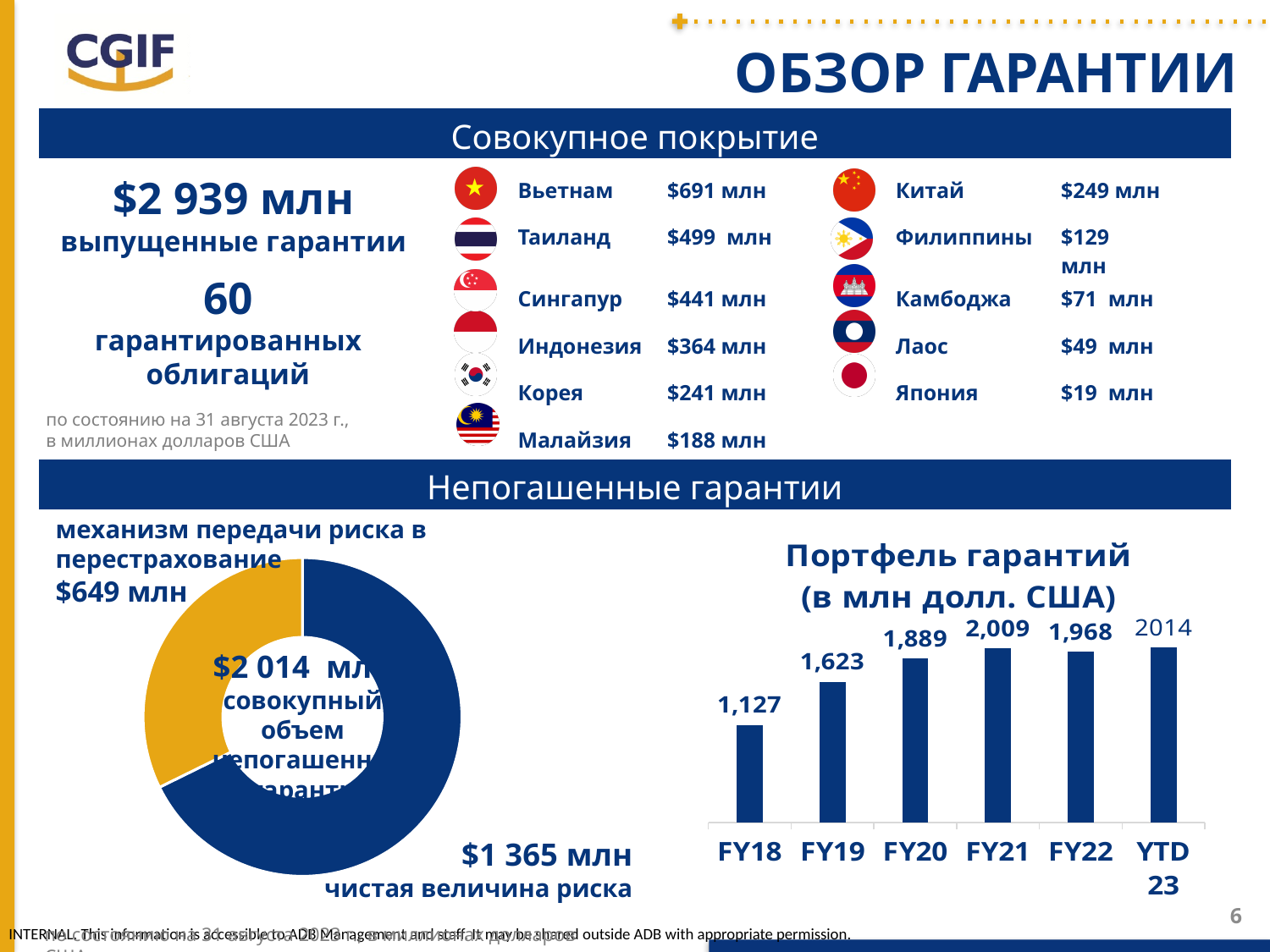
In the bar chart 'Портфель гарантий (в млн долл. США)', which is larger, FY20 or FY22? FY22 What kind of chart is shown on the bottom left of the slide? donut chart What kind of chart is 'Портфель гарантий (в млн долл. США)'? bar chart In the bar chart 'Портфель гарантий (в млн долл. США)', do the values rise or fall from FY18 to FY21? rise In the bar chart 'Портфель гарантий (в млн долл. США)', what is the value for FY21? 2,009 In the bar chart 'Портфель гарантий (в млн долл. США)', which period has the lowest value? FY18 In the bar chart 'Портфель гарантий (в млн долл. США)', what is the difference between FY19 and FY18? 496 How many periods are shown in the bar chart 'Портфель гарантий (в млн долл. США)'? 6 In the donut chart on the bottom left, what is the value of the 'чистая величина риска' slice? $1 365 млн In the bar chart 'Портфель гарантий (в млн долл. США)', what is the value for YTD 23? 2014 In the bar chart 'Портфель гарантий (в млн долл. США)', what is the value for FY18? 1,127 In the donut chart on the bottom left, what is the value of the 'механизм передачи риска в перестрахование' slice? $649 млн